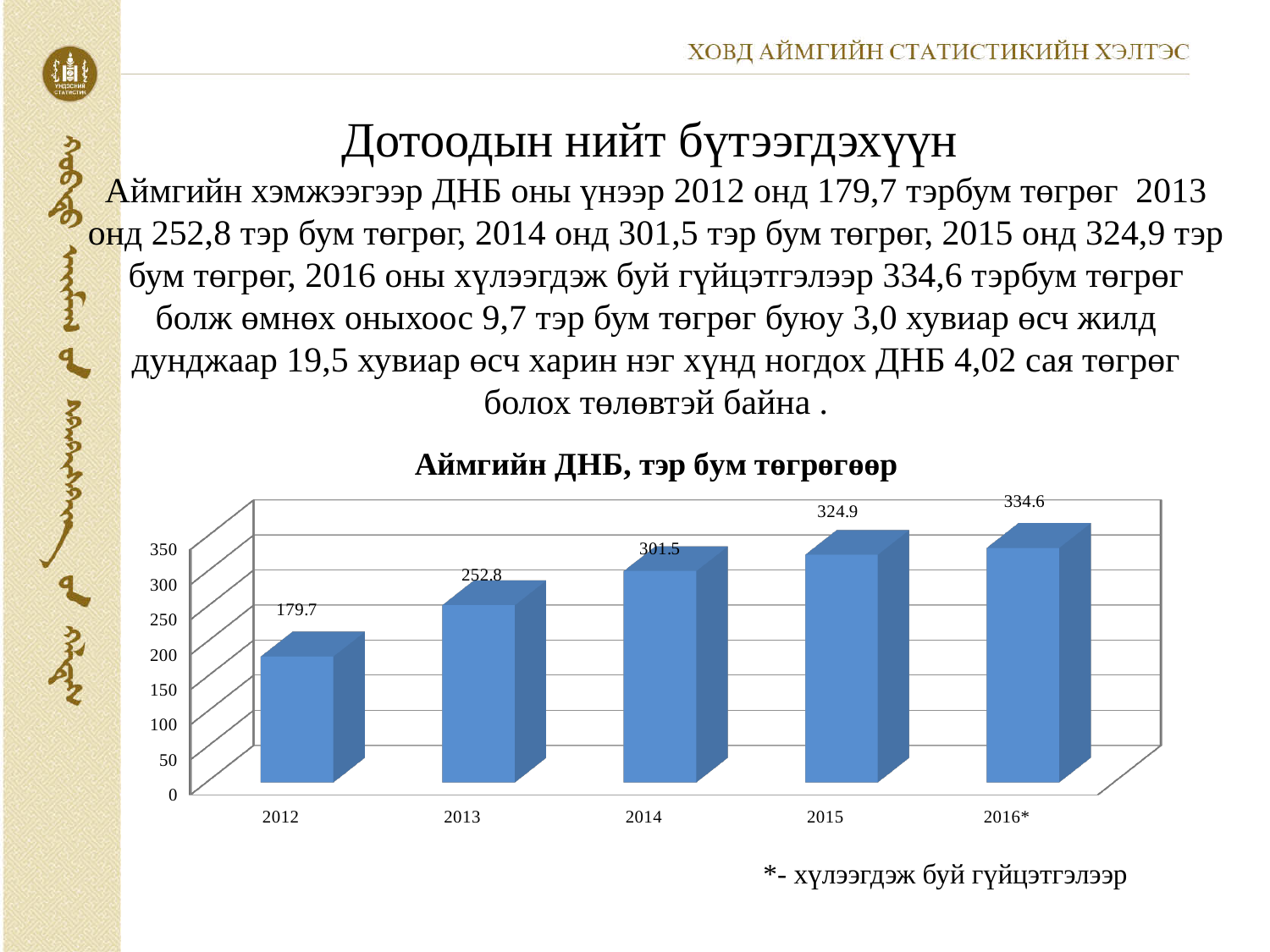
Which is larger, the value for 2013 or the value for 2015? 2015 What is the title of the chart? Аймгийн ДНБ, тэр бум төгрөгөөр What is the value for 2012 in the chart? 179.7 What is the difference between the values for 2016* and 2015? 9.7 Which year has the highest value in the chart? 2016* Do the values rise or fall from 2012 to 2016*? rise What is the difference between the values for 2013 and 2012? 73.1 What is the value for 2016* in the chart? 334.6 What kind of chart is shown on the slide? bar chart What is the value for 2014 in the chart? 301.5 Which year has the lowest value in the chart? 2012 How many years are shown on the x axis of the chart? 5